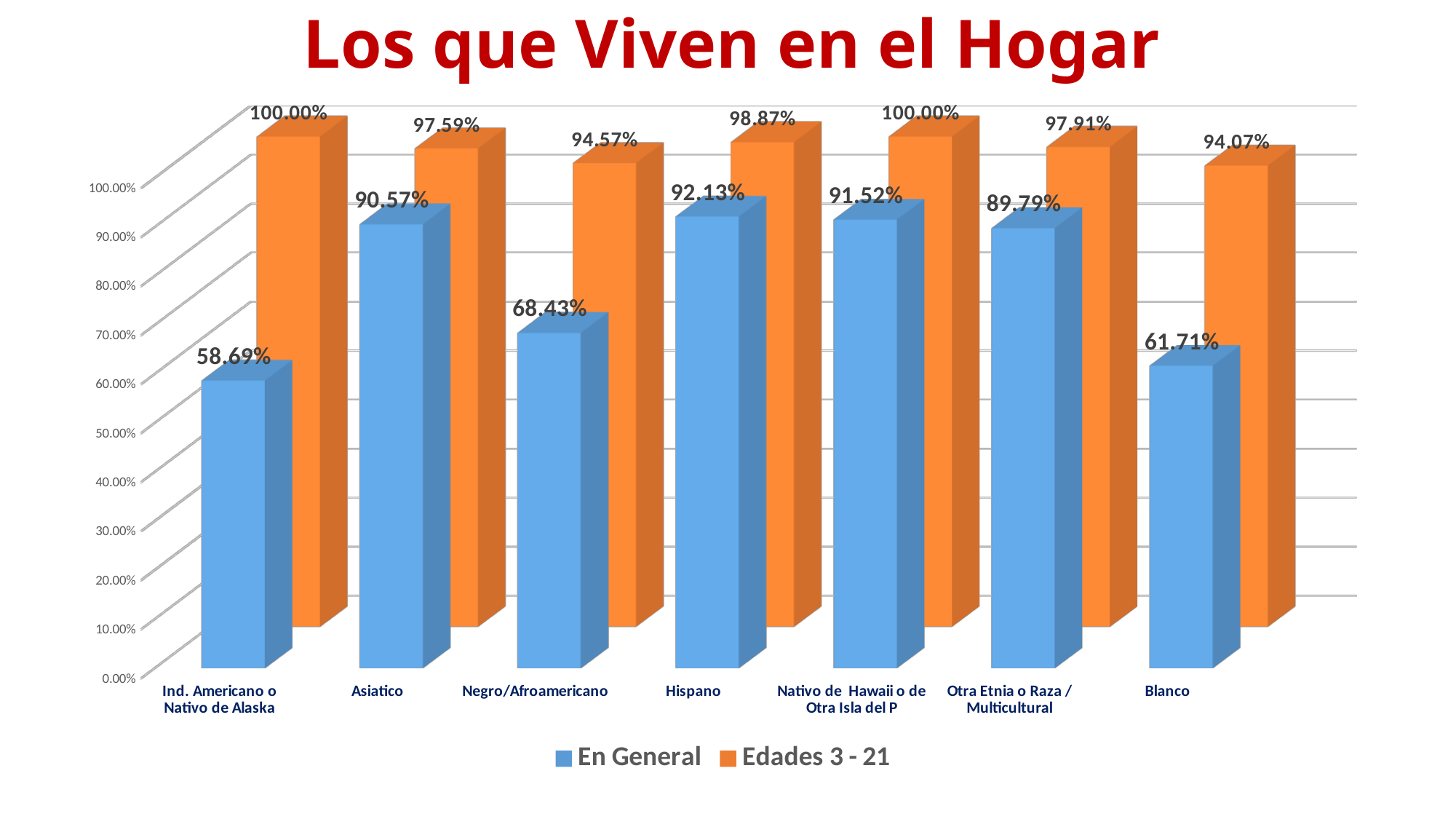
Which category has the highest En General value? Hispano What is the En General value for Negro/Afroamericano? 68.43% Which is larger: the En General value for Asiatico or for Blanco? Asiatico What kind of chart is shown on the slide? Bar chart How many categories are shown on the x axis? 7 What is the value for Asiatico in the En General series? 90.57% Which category has the lowest Edades 3 - 21 value? Blanco What is the difference between the Edades 3 - 21 and En General values for Ind. Americano o Nativo de Alaska? 41.31% How many series does the legend list? 2 What is the value for Blanco in the Edades 3 - 21 series? 94.07% What is the difference between the Edades 3 - 21 and En General values for Blanco? 32.36% Which category has the lowest En General value? Ind. Americano o Nativo de Alaska